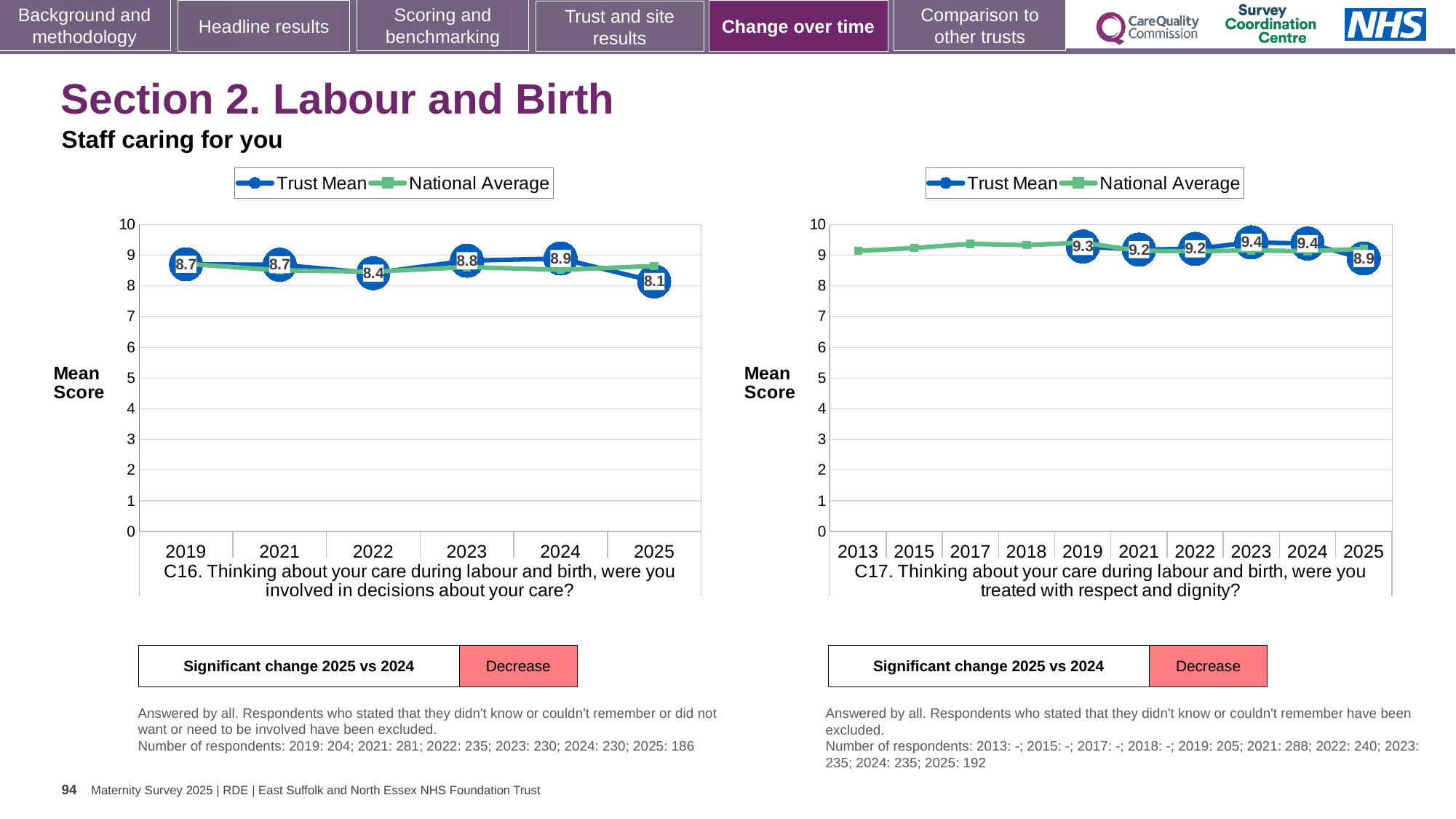
In the C16 chart on the left, what is the Trust Mean for 2025? 8.1 In the C16 chart on the left, how many years are shown on the x axis? 6 What type of chart is the C16 chart on the left? Line chart In the C17 chart on the right, is the Trust Mean for 2023 larger or smaller than the Trust Mean for 2025? larger In the C16 chart on the left, which year has the highest Trust Mean? 2024 In the C16 chart on the left, what is the difference between the Trust Mean for 2024 and 2025? 0.8 In the C16 chart on the left, which year has the lowest Trust Mean? 2025 In the C17 chart on the right, which year has the lowest labelled Trust Mean? 2025 In the C17 chart on the right, how many series does the legend list? 2 In the C17 chart on the right, is the National Average for 2013 greater or less than 8? greater In the C16 chart on the left, what is the Trust Mean for 2022? 8.4 In the C17 chart on the right, what is the Trust Mean for 2019? 9.3